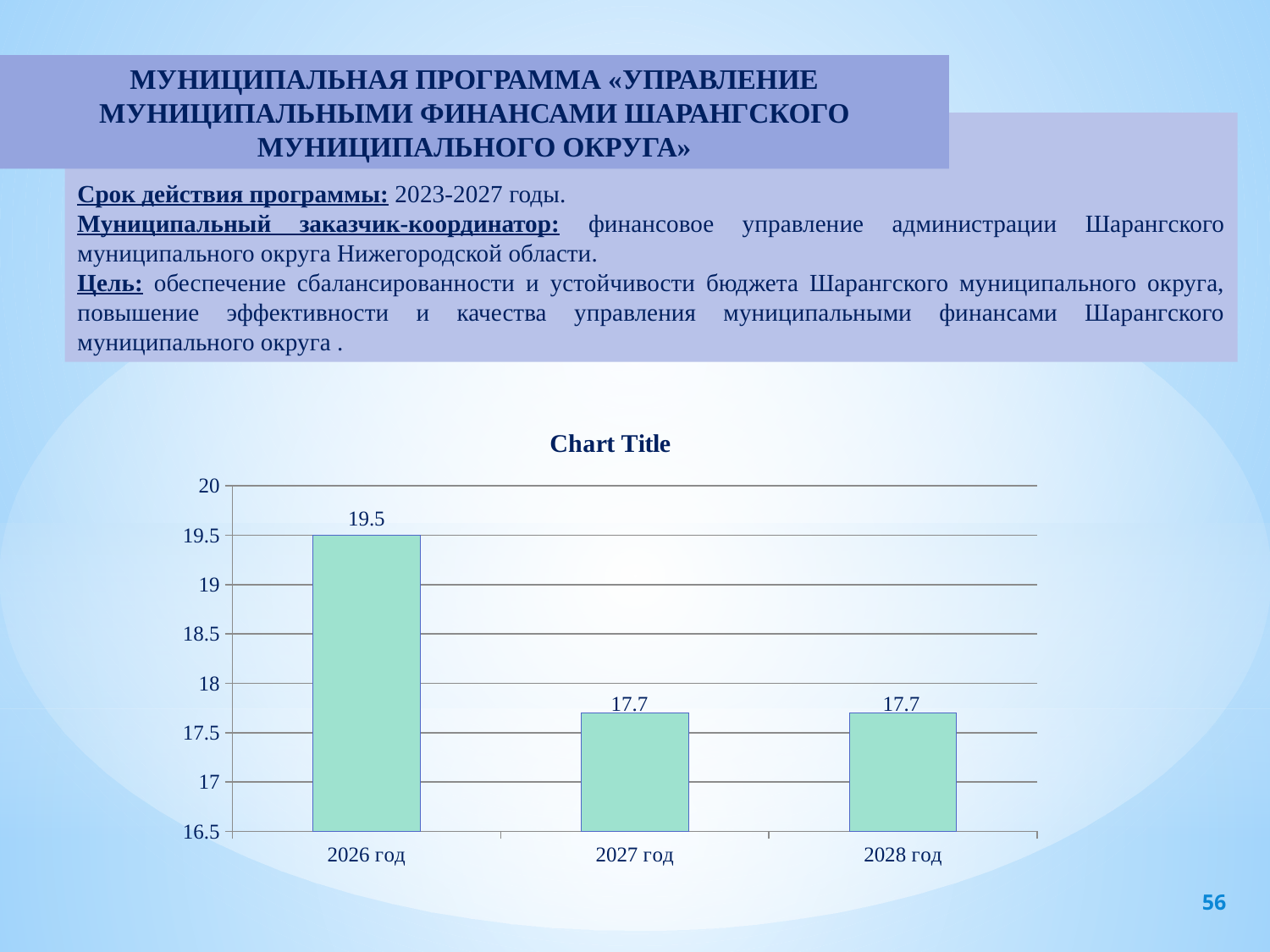
What is the title of the chart? Chart Title How many categories are shown on the x axis? 3 What kind of chart is shown on the slide? bar chart What is the value for 2026 год? 19.5 Is the value for 2026 год greater or less than 19? greater What is the value for 2027 год? 17.7 What is the value for 2028 год? 17.7 Which is larger, the value for 2026 год or the value for 2028 год? 2026 год Which year has the highest value? 2026 год Do the values rise or fall from 2026 год to 2027 год? fall Is the value for 2027 год greater or less than 18? less What is the difference between the values for 2026 год and 2027 год? 1.8